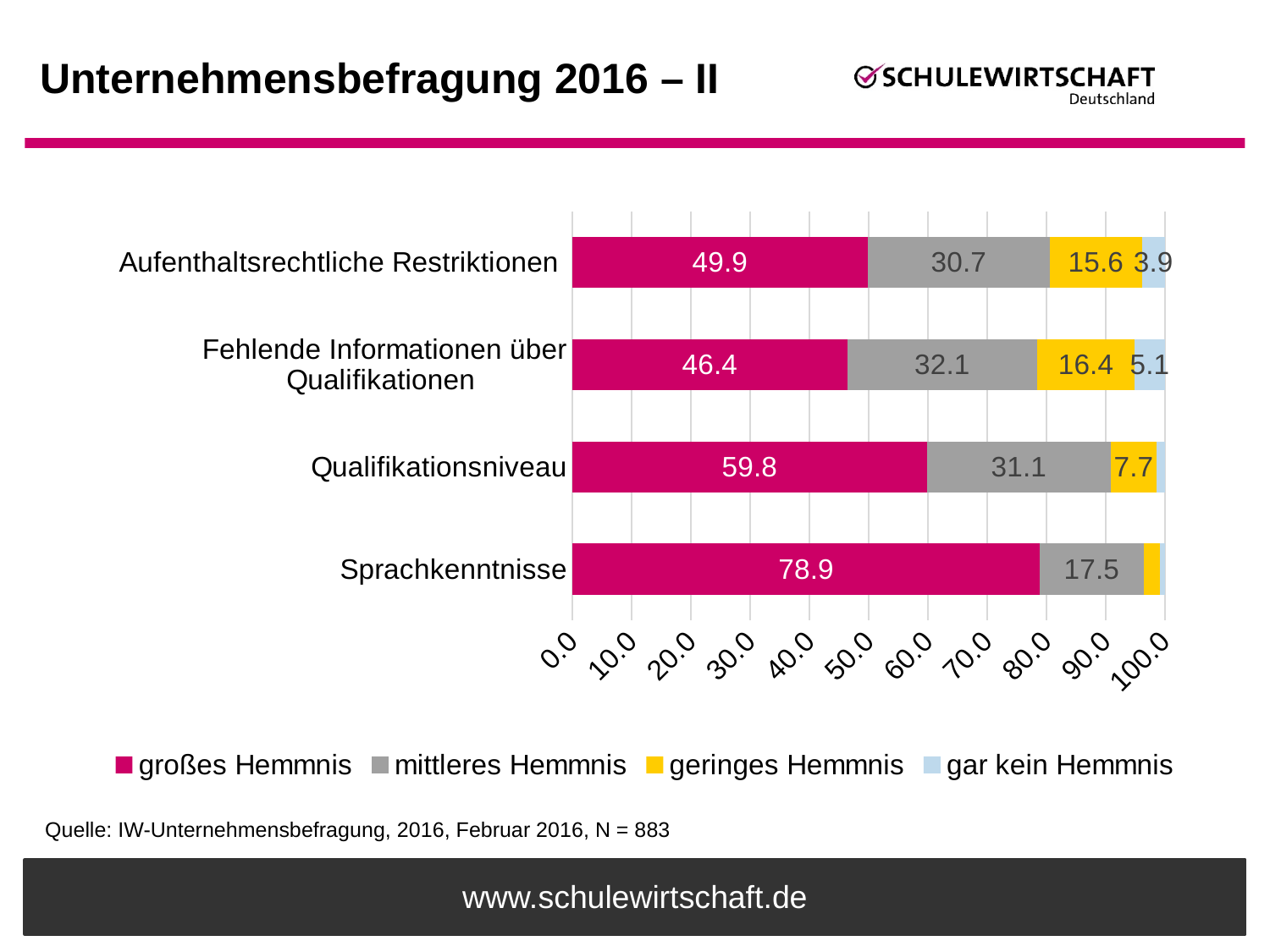
What kind of chart is shown on the slide? Stacked bar chart Which category has the highest value for "großes Hemmnis"? Sprachkenntnisse What is the value for "gar kein Hemmnis" for Fehlende Informationen über Qualifikationen? 5.1 What is the value for "großes Hemmnis" for Sprachkenntnisse? 78.9 Is the "großes Hemmnis" value for Qualifikationsniveau greater or less than 50.0? greater Which category has the lowest value for "großes Hemmnis"? Fehlende Informationen über Qualifikationen How many series does the legend list? 4 Which is larger: the "geringes Hemmnis" value for Aufenthaltsrechtliche Restriktionen or for Fehlende Informationen über Qualifikationen? Fehlende Informationen über Qualifikationen What is the value for "geringes Hemmnis" for Qualifikationsniveau? 7.7 What is the value for "mittleres Hemmnis" for Aufenthaltsrechtliche Restriktionen? 30.7 How many categories are shown on the chart? 4 What is the difference between the "großes Hemmnis" values for Sprachkenntnisse and Qualifikationsniveau? 19.1